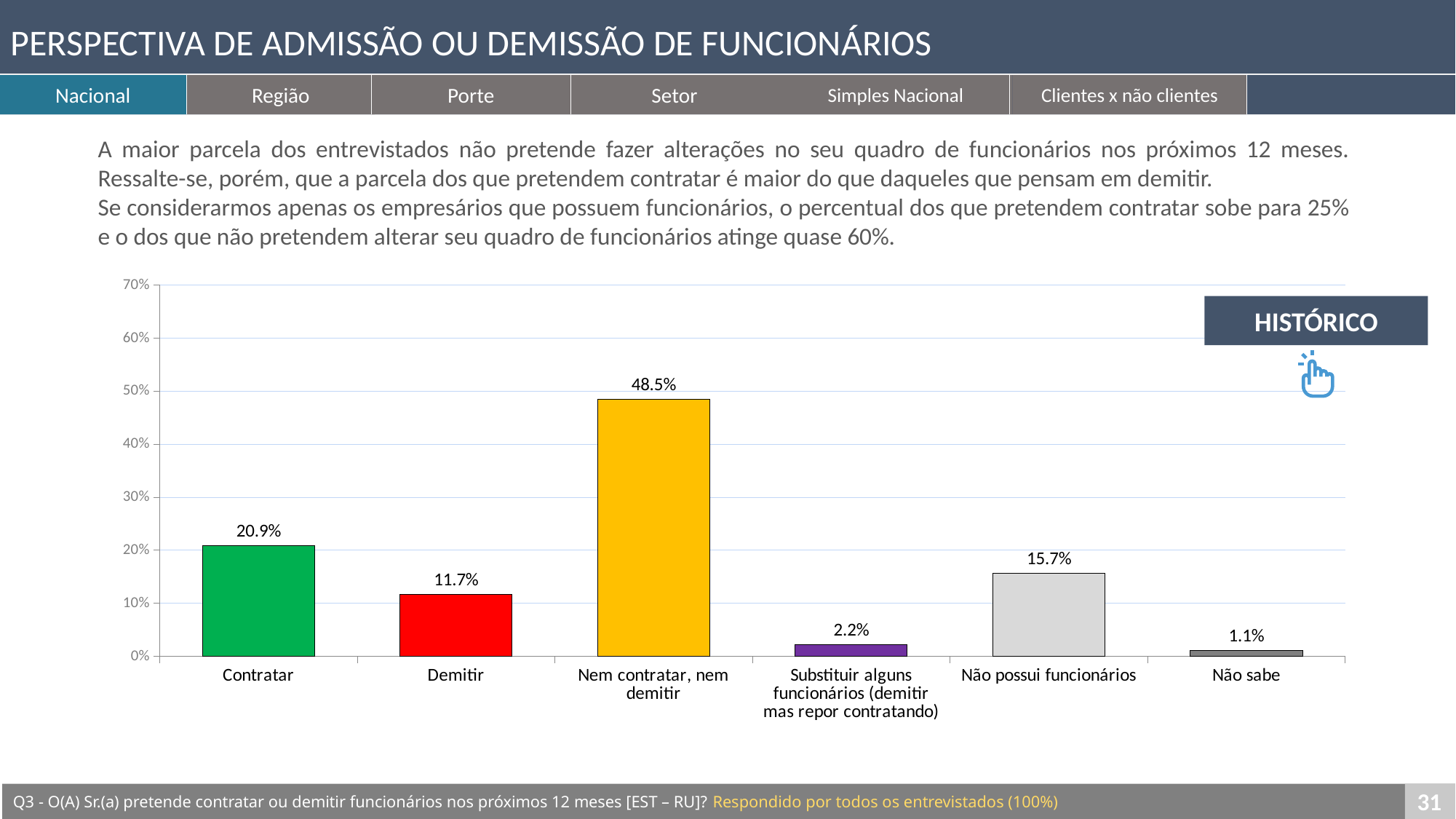
What is the value for Substituir alguns funcionários (demitir mas repor contratando)? 2.2% What colour is the bar for Contratar? green How many categories are shown on the x axis? 6 Which category has the lowest value? Não sabe What is the value for Demitir? 11.7% Which is larger, the value for Não possui funcionários or the value for Demitir? Não possui funcionários What is the difference between the values for Contratar and Demitir? 9.2% Which category has the highest value? Nem contratar, nem demitir What kind of chart is shown on the slide? bar chart Is the value for Nem contratar, nem demitir greater or less than 40%? greater What is the value for Não possui funcionários? 15.7% What is the value for Contratar? 20.9%